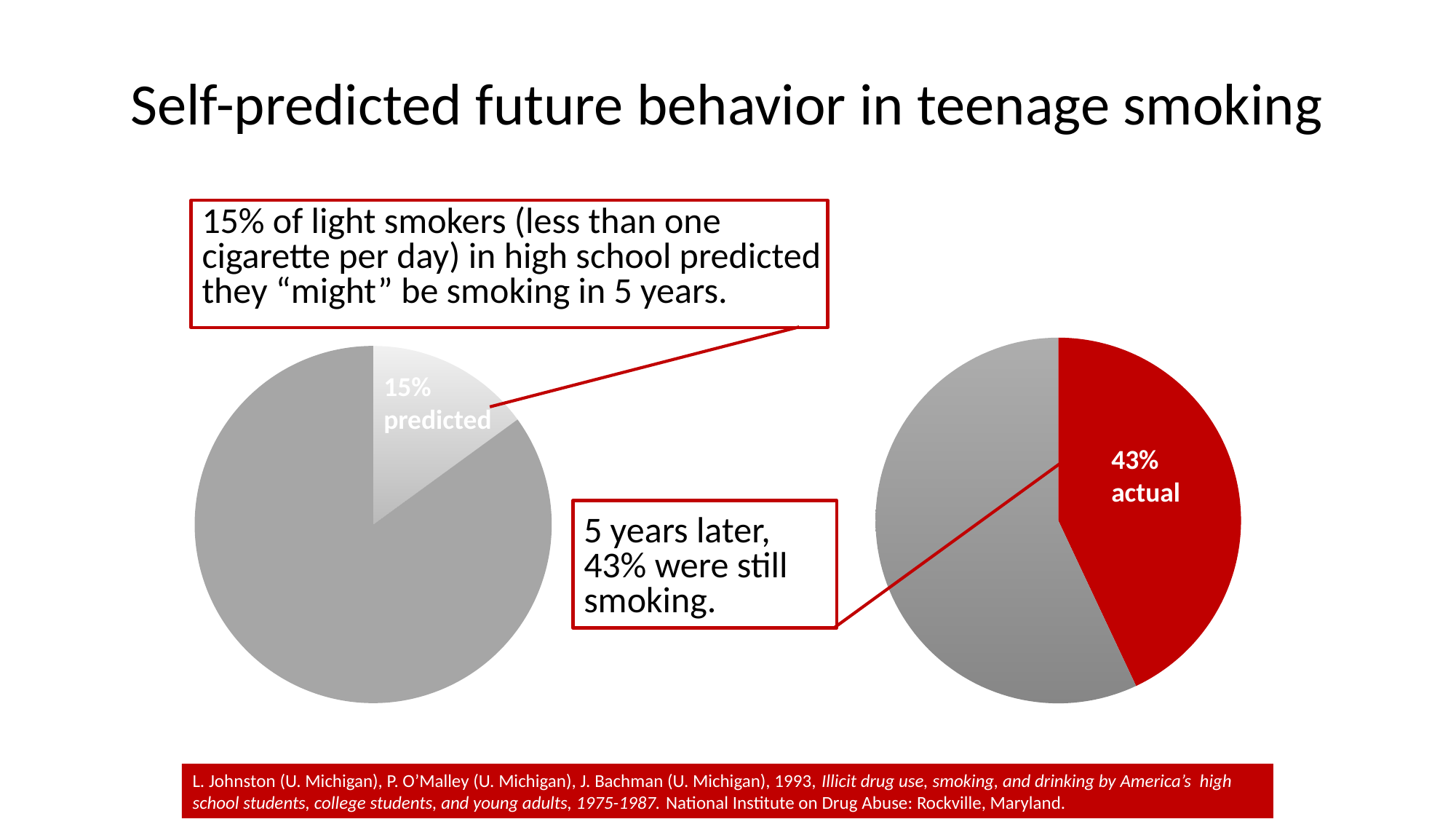
What kind of chart is the left chart on the slide? pie chart What is the difference between the actual share (right pie chart) and the predicted share (left pie chart)? 28 percentage points How many slices does the left pie chart have? 2 In the left pie chart, what value is printed on the highlighted slice? 15% How many slices does the right pie chart have? 2 In the right pie chart, what value is printed on the red slice? 43% How many pie charts are shown on the slide? 2 Which is larger, the predicted share in the left pie chart or the actual share in the right pie chart? actual (43%) What colour is the 43% actual slice in the right pie chart? red In the right pie chart, does the 43% actual slice cover more or less than half of the pie? less What is the label on the highlighted slice of the left pie chart? 15% predicted What is the label on the red slice of the right pie chart? 43% actual